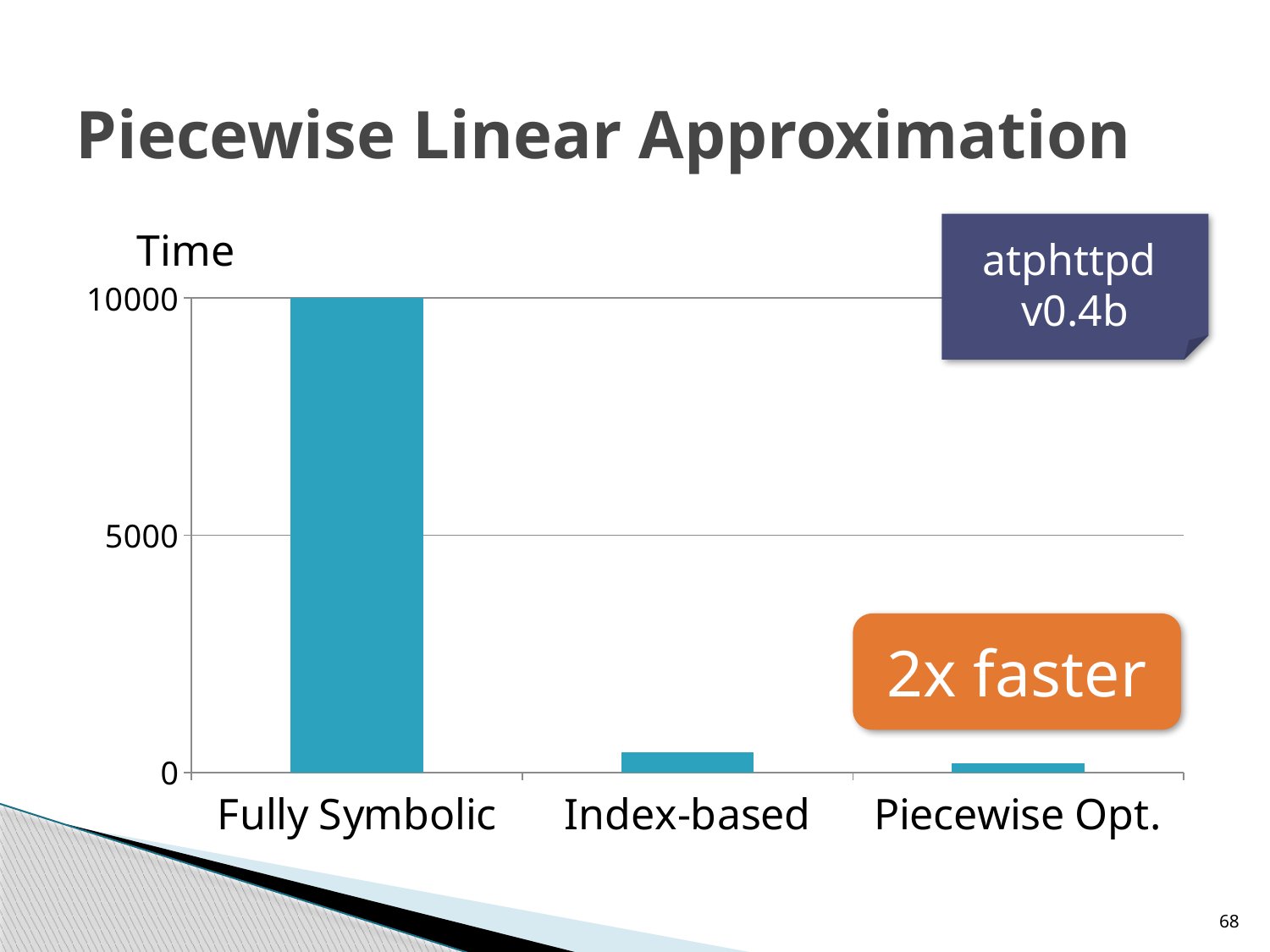
Is the value for Index-based greater or less than 5000? less How many categories are shown on the x axis of the chart? 3 Which is larger, the value for Fully Symbolic or the value for Index-based? Fully Symbolic What is the label on the vertical axis of the chart? Time Which category has the highest value in the chart? Fully Symbolic Is the value for Piecewise Opt. greater or less than 5000? less Do the values rise or fall from left to right along the x axis? fall Which is larger, the value for Index-based or the value for Piecewise Opt.? Index-based What does the orange callout on the chart say? 2x faster What kind of chart is shown on the slide? bar chart Which category has the lowest value in the chart? Piecewise Opt.